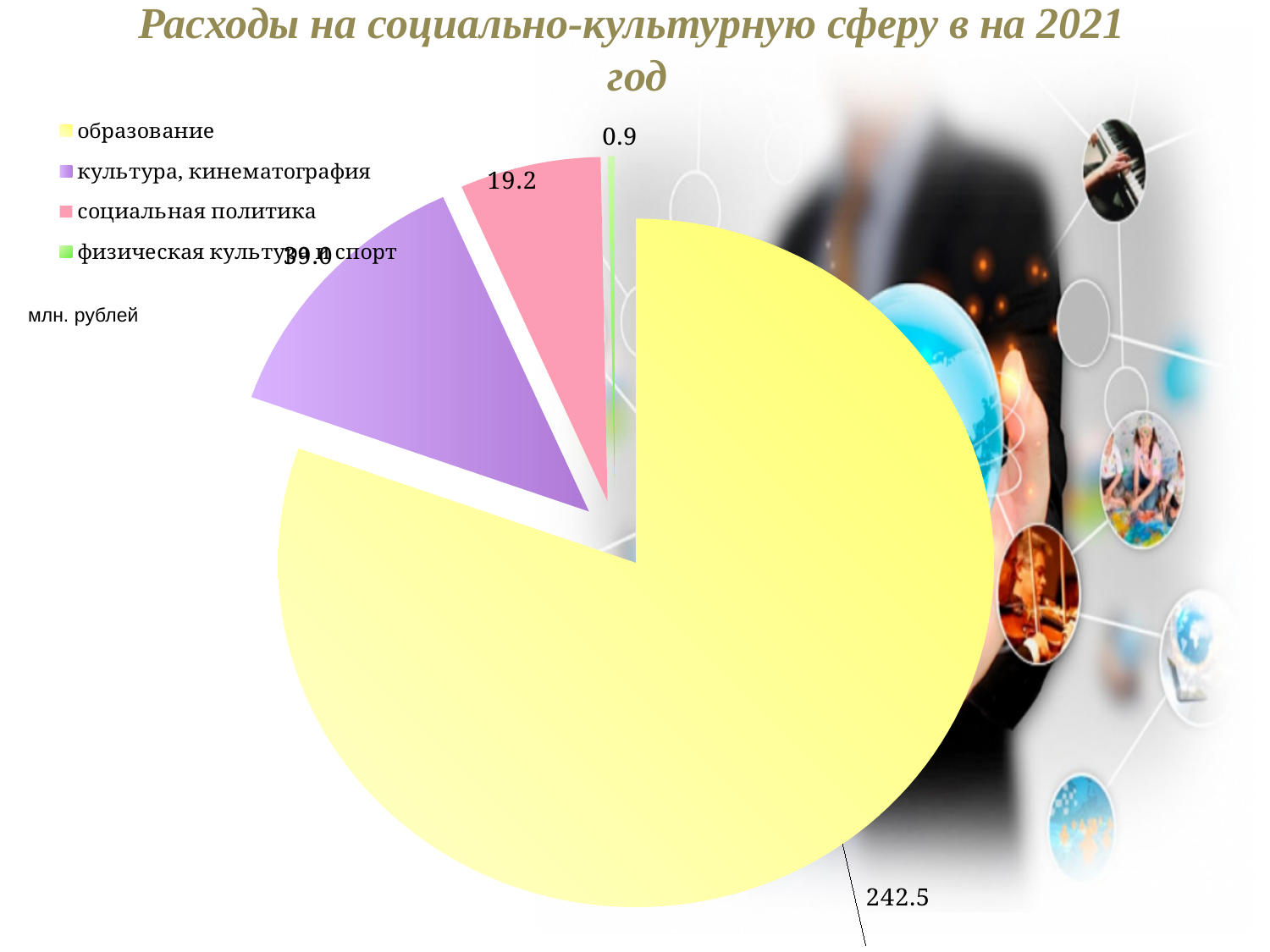
Which is larger, социальная политика or физическая культура и спорт? социальная политика What is the value for социальная политика? 19.2 What is the value for образование? 242.5 What is the difference between the values for социальная политика and физическая культура и спорт? 18.3 Which category has the largest slice of the pie? образование Which category has the smallest slice of the pie? физическая культура и спорт What is the difference between the values for образование and социальная политика? 223.3 What is the value for физическая культура и спорт? 0.9 Which is larger, образование or культура, кинематография? образование What unit is stated for the values in the chart? млн. рублей What type of chart is shown on the slide? pie chart How many categories does the pie chart show? 4